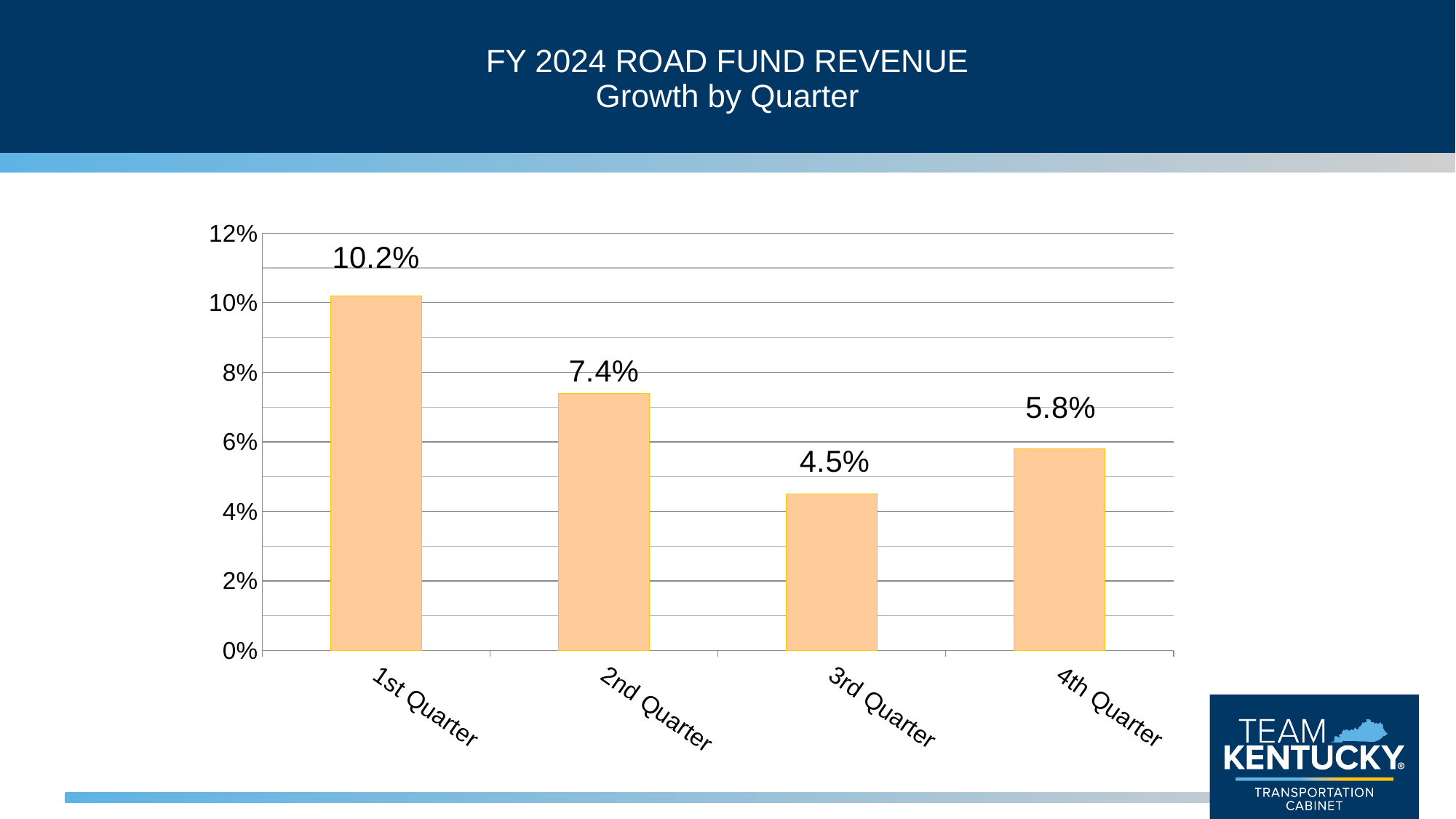
What is the title of the chart on the slide? FY 2024 ROAD FUND REVENUE Growth by Quarter Which is larger, the growth for the 2nd Quarter or the 4th Quarter? 2nd Quarter What is the growth value for the 4th Quarter? 5.8% What is the difference between the 1st Quarter and 2nd Quarter growth values? 2.8% How many quarters are shown on the chart? 4 What is the growth value for the 3rd Quarter? 4.5% Which quarter has the lowest growth? 3rd Quarter What is the growth value for the 1st Quarter? 10.2% Which quarter has the highest growth? 1st Quarter What is the difference between the 4th Quarter and 3rd Quarter growth values? 1.3% Is the value for the 2nd Quarter greater or less than 8%? less What kind of chart is shown on the slide? bar chart